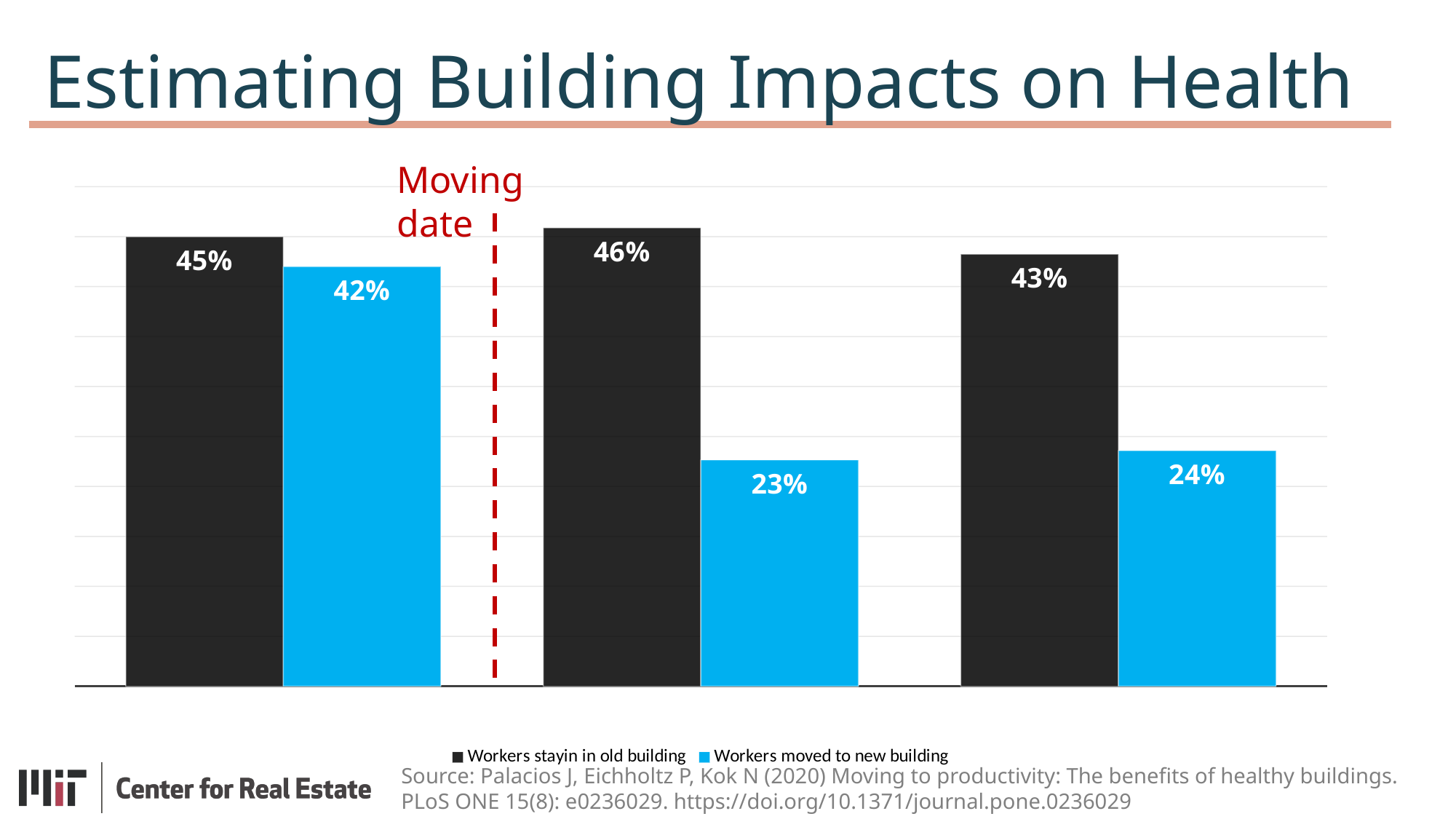
What is the lowest value shown for workers moved to the new building? 23% How many groups of bars are plotted in the chart? 3 In the middle group of bars, what is the value for workers moved to the new building? 23% In the rightmost group of bars, what is the value for workers staying in the old building? 43% What does the red dashed vertical line in the chart mark? Moving date How many series does the legend list? 2 In the first (leftmost) group of bars, what is the value for workers moved to the new building? 42% In the rightmost group of bars, which series has the larger value: workers staying in the old building or workers moved to the new building? Workers staying in the old building What is the highest value shown for workers staying in the old building? 46% In the first (leftmost) group of bars, what is the value for workers staying in the old building? 45% In the middle group of bars, what is the difference between the value for workers staying in the old building and the value for workers moved to the new building? 23% What kind of chart is shown on the slide? bar chart